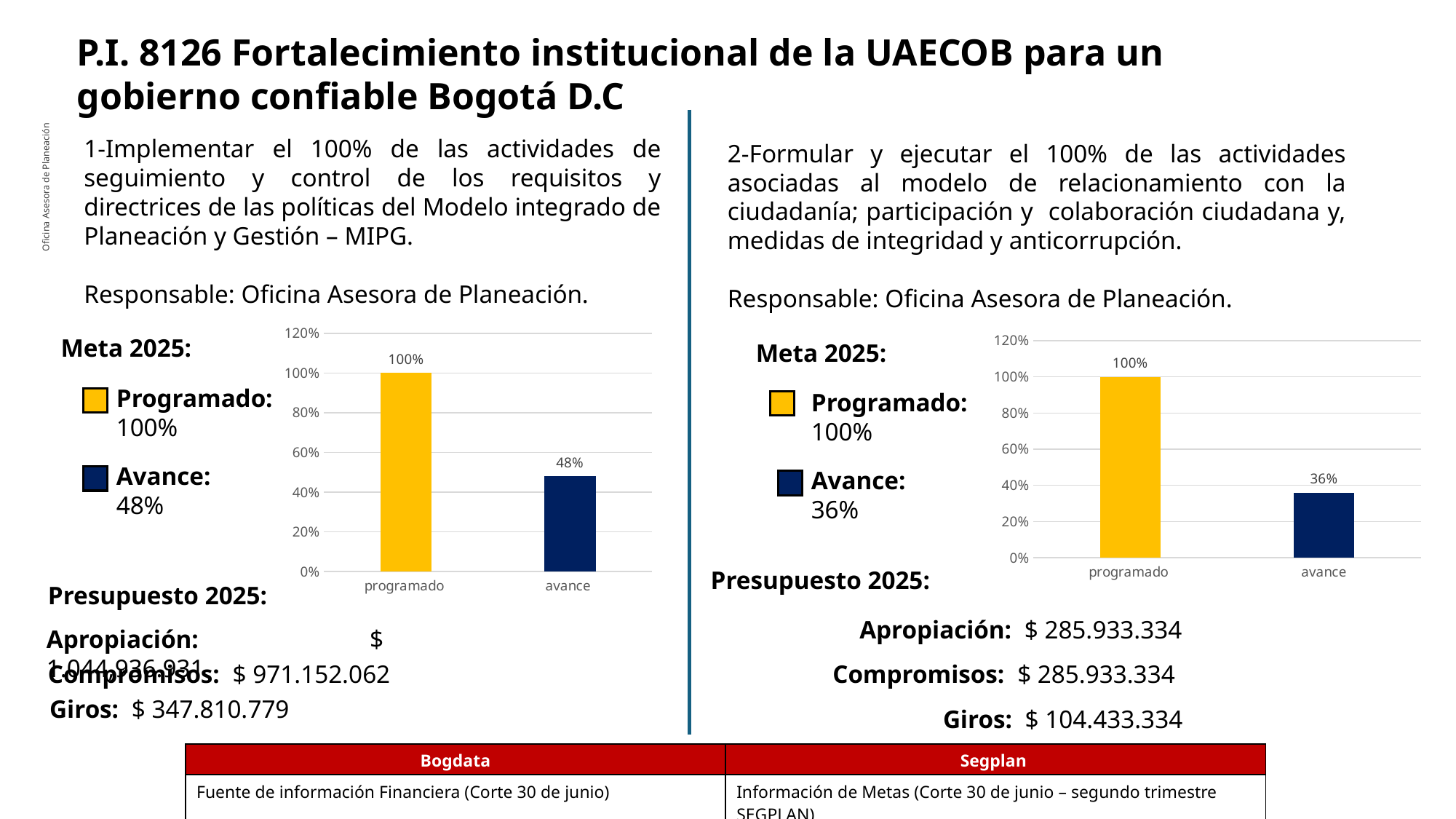
In the left chart, what is the value for avance? 48% In the left chart, what colour is the programado bar? yellow What kind of chart is the right chart? bar chart How many categories are shown in the left chart? 2 In the right chart, what is the value for avance? 36% In the left chart, what is the value for programado? 100% In the right chart, what is the value for programado? 100% In the right chart, is the value for avance greater or less than 40%? less In the left chart, which category has the lowest value? avance In the right chart, what is the difference between programado and avance? 64% In the left chart, what is the difference between programado and avance? 52% In the right chart, which category has the highest value? programado